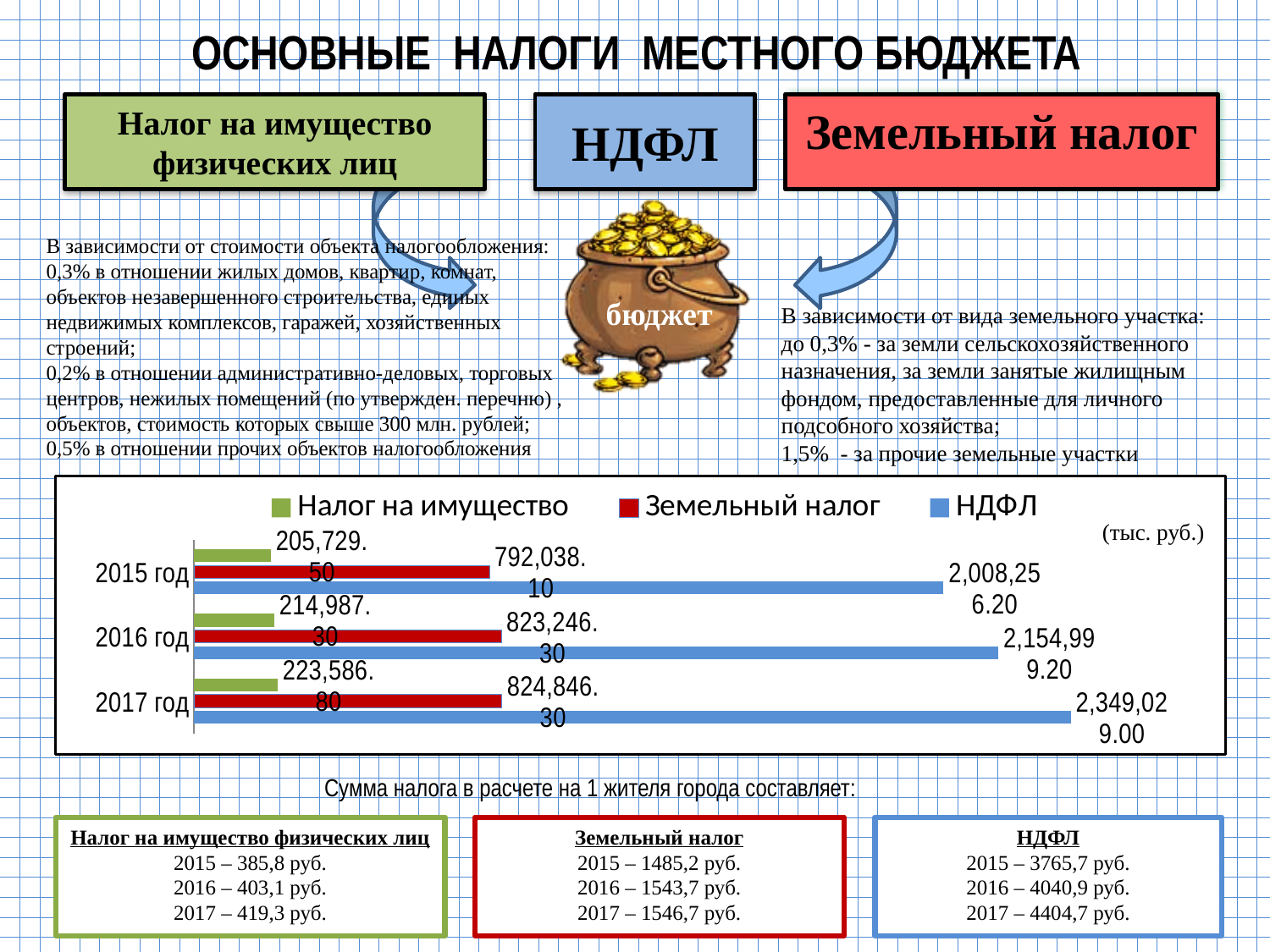
Do the values of Налог на имущество rise or fall from 2015 год to 2017 год? rise Which year has the highest value for НДФЛ? 2017 год What is the difference between Налог на имущество in 2017 год and in 2015 год? 17,857.30 What is the value of Налог на имущество for 2015 год? 205,729.50 What is the value of НДФЛ for 2015 год? 2,008,256.20 What type of chart is shown on the slide? bar chart How many year categories are plotted in the chart? 3 Which series has the lowest value in 2015 год? Налог на имущество What is the value of Земельный налог for 2016 год? 823,246.30 What is the value of НДФЛ for 2017 год? 2,349,029.00 Which is larger: Земельный налог in 2017 год or Земельный налог in 2016 год? Земельный налог in 2017 год How many series does the chart legend list? 3